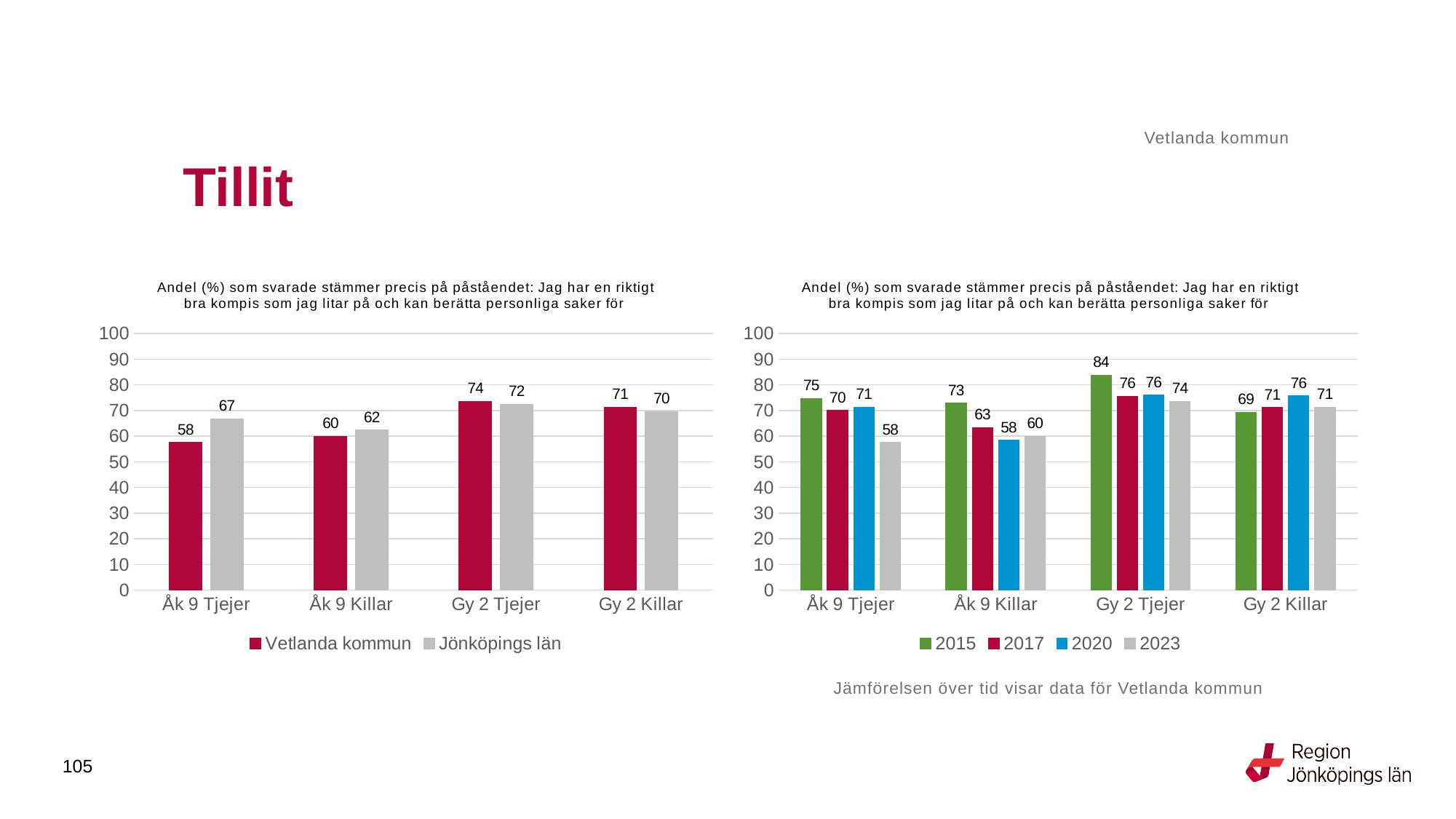
In the left chart, how many series does the legend list? 2 In the right chart, what is the value for 2020 for Åk 9 Killar? 58 In the right chart, which is larger for Gy 2 Killar: the value for 2015 or the value for 2020? 2020 In the left chart, which category has the highest value for Vetlanda kommun? Gy 2 Tjejer In the right chart, how many series does the legend list? 4 In the left chart, what is the value for Vetlanda kommun for Åk 9 Tjejer? 58 In the right chart, what is the value for 2015 for Gy 2 Tjejer? 84 In the right chart, how many categories are shown on the x axis? 4 In the right chart, which year has the lowest value for Åk 9 Tjejer? 2023 In the left chart, what is the difference between Jönköpings län and Vetlanda kommun for Åk 9 Tjejer? 9 In the left chart, what is the value for Jönköpings län for Gy 2 Tjejer? 72 What kind of chart is the left chart? Bar chart